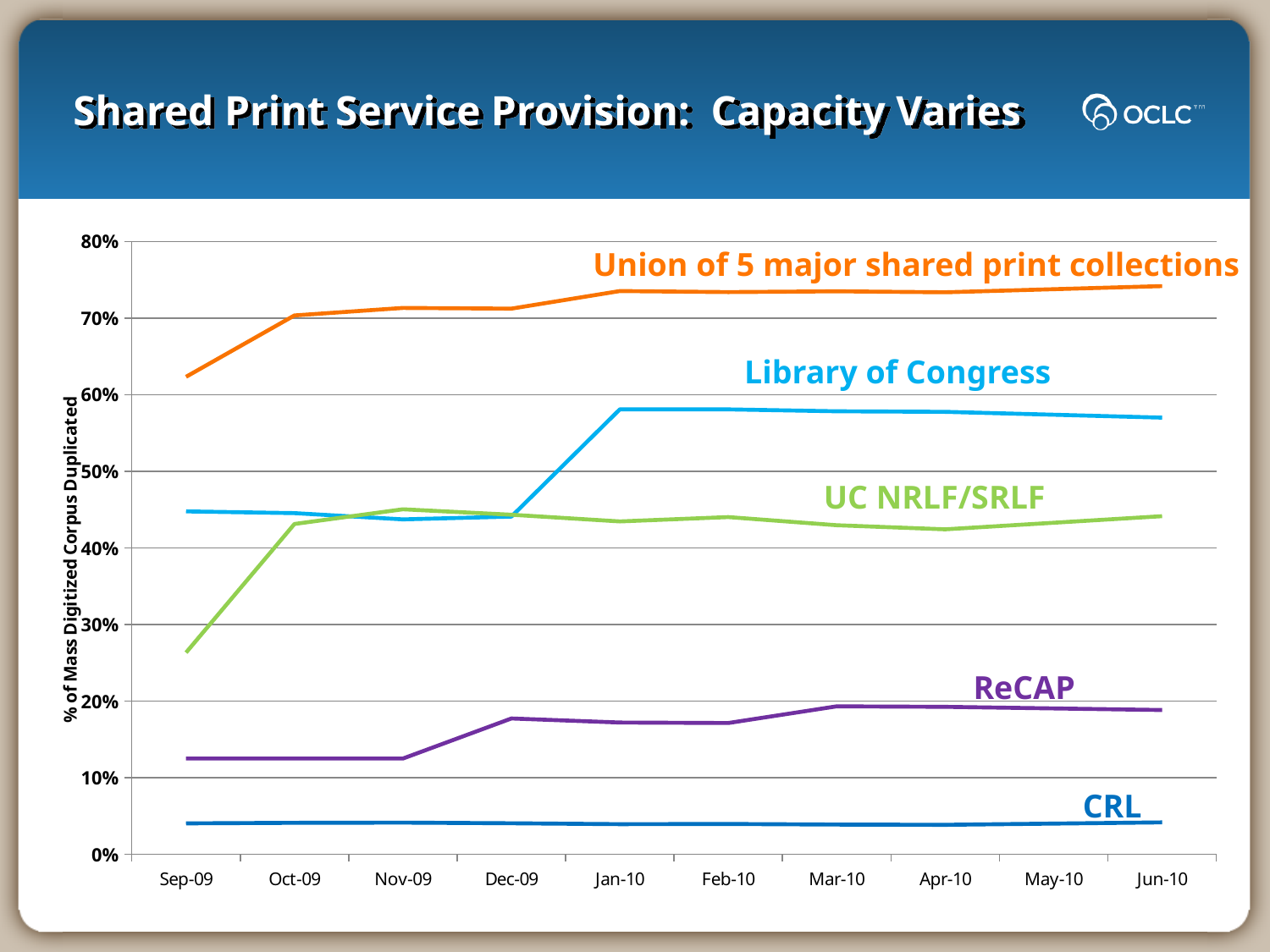
What is the label on the y axis of the chart? % of Mass Digitized Corpus Duplicated Which series has the lowest values across the whole period? CRL Is the value for Library of Congress at Jan-10 greater or less than 60%? less At Jun-10, which is larger: Library of Congress or UC NRLF/SRLF? Library of Congress Which series has the highest values across the whole period? Union of 5 major shared print collections How many time points are shown along the x axis? 10 Is the value for UC NRLF/SRLF at Sep-09 greater or less than 30%? less How many data series (lines) are plotted on the chart? 5 Is the value for Union of 5 major shared print collections at Sep-09 greater or less than 60%? greater What kind of chart is shown on the slide? line chart Does the Library of Congress line rise or fall overall from Sep-09 to Jun-10? rise